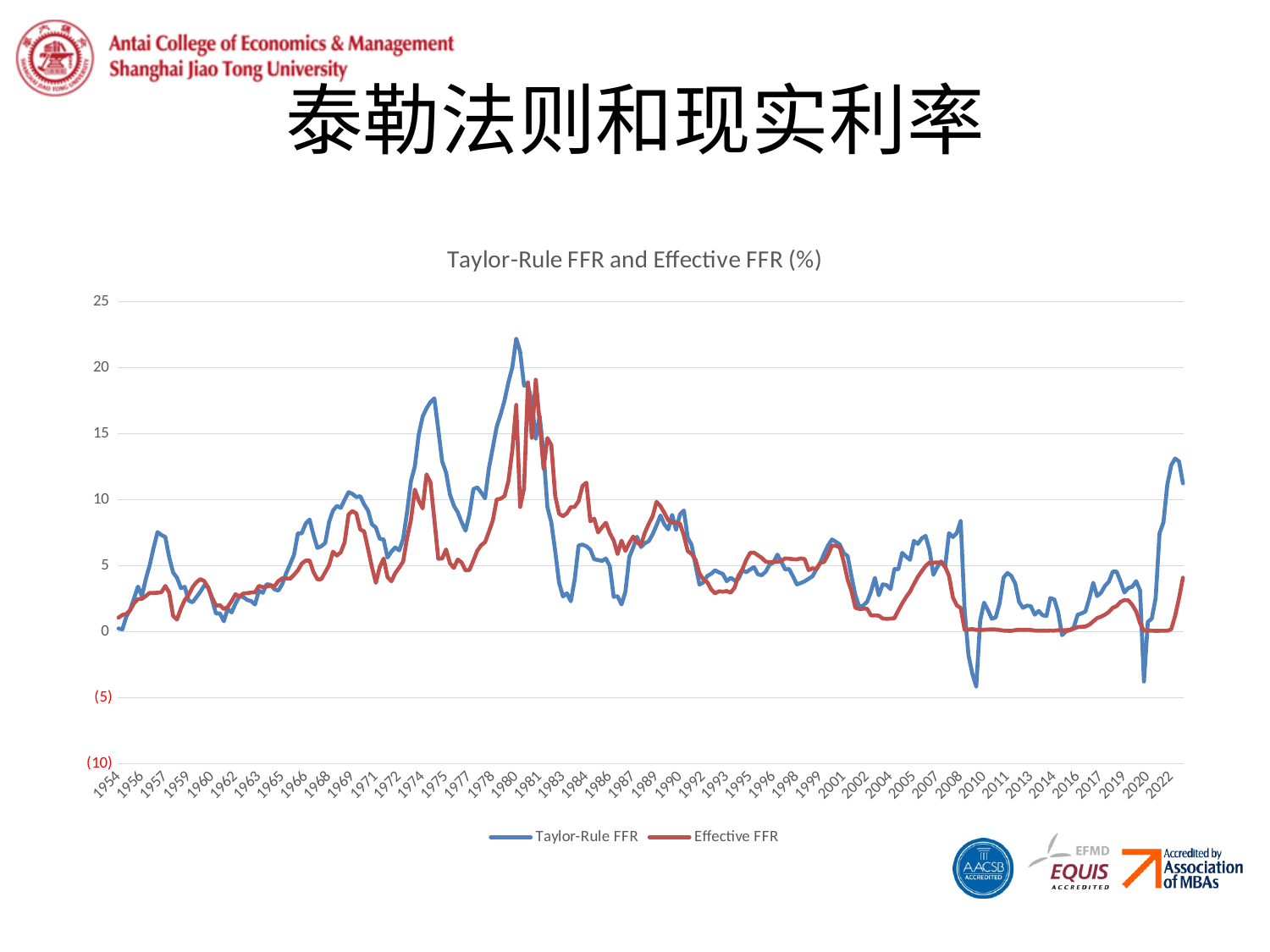
Around 2022, which series is higher, Taylor-Rule FFR or Effective FFR? Taylor-Rule FFR Which colour is used for the Effective FFR series? red Is the lowest value of the Taylor-Rule FFR around 2010 greater or less than 0? less Is the peak value of the Effective FFR around 1981 greater or less than 15? greater Is the value of the Taylor-Rule FFR at the end of the series in 2022 greater or less than 10? greater How many series does the legend list? 2 Which series reaches the lowest value anywhere on the chart? Taylor-Rule FFR What kind of chart is shown on the slide? line chart What is the title of the chart? Taylor-Rule FFR and Effective FFR (%) Which series reaches the highest value anywhere on the chart? Taylor-Rule FFR